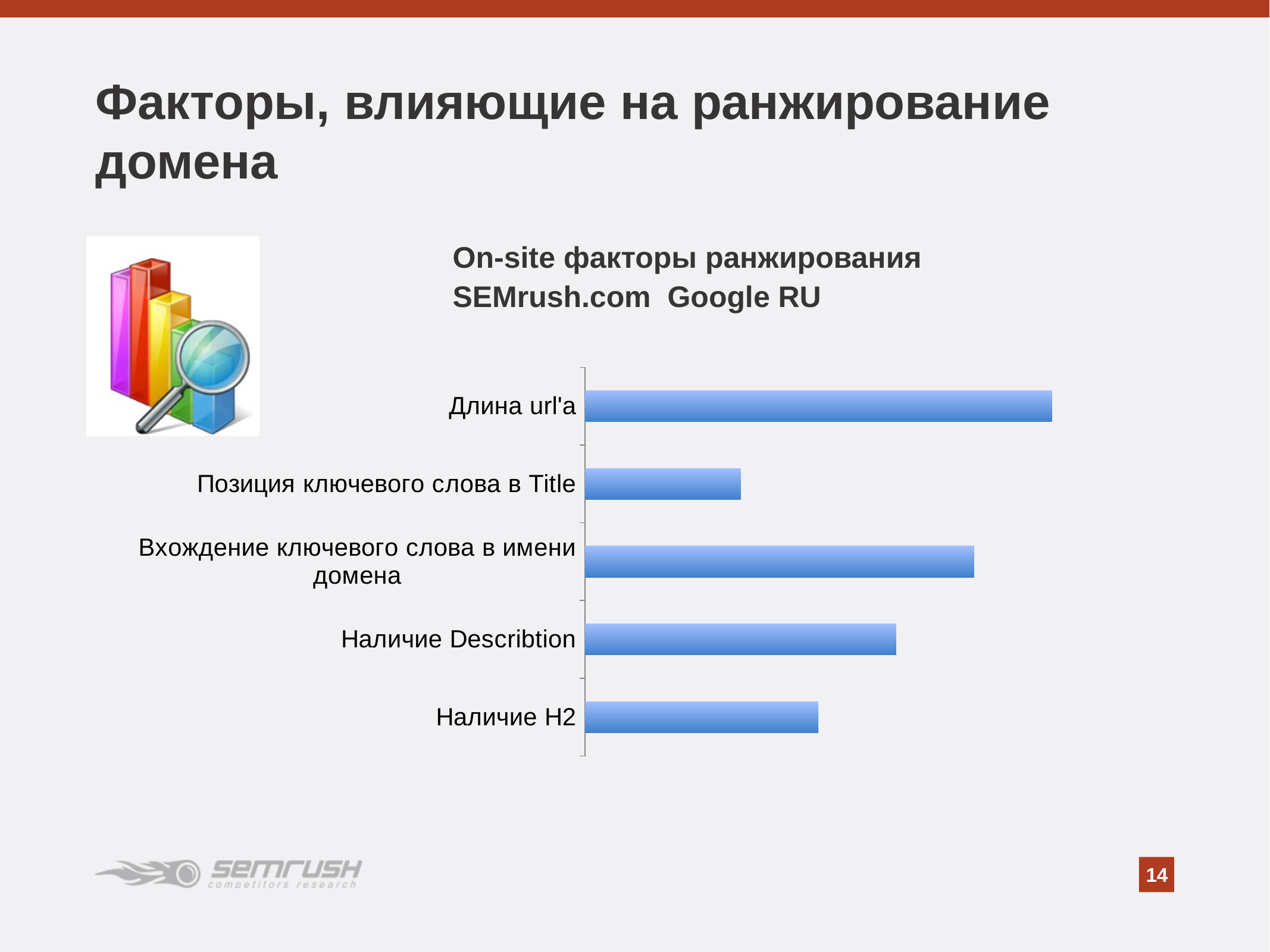
Which has the larger value: Вхождение ключевого слова в имени домена or Позиция ключевого слова в Title? Вхождение ключевого слова в имени домена Which has the larger value: Наличие Describtion or Наличие H2? Наличие Describtion Which category has the longest bar in the chart? Длина url'a Which category has the second-longest bar in the chart? Вхождение ключевого слова в имени домена What is the title of the chart? On-site факторы ранжирования SEMrush.com Google RU What kind of chart is shown on the slide? bar chart Which category has the shortest bar in the chart? Позиция ключевого слова в Title How many categories does the bar chart show? 5 Which has the larger value: Наличие H2 or Позиция ключевого слова в Title? Наличие H2 What colour are the bars in the chart? blue